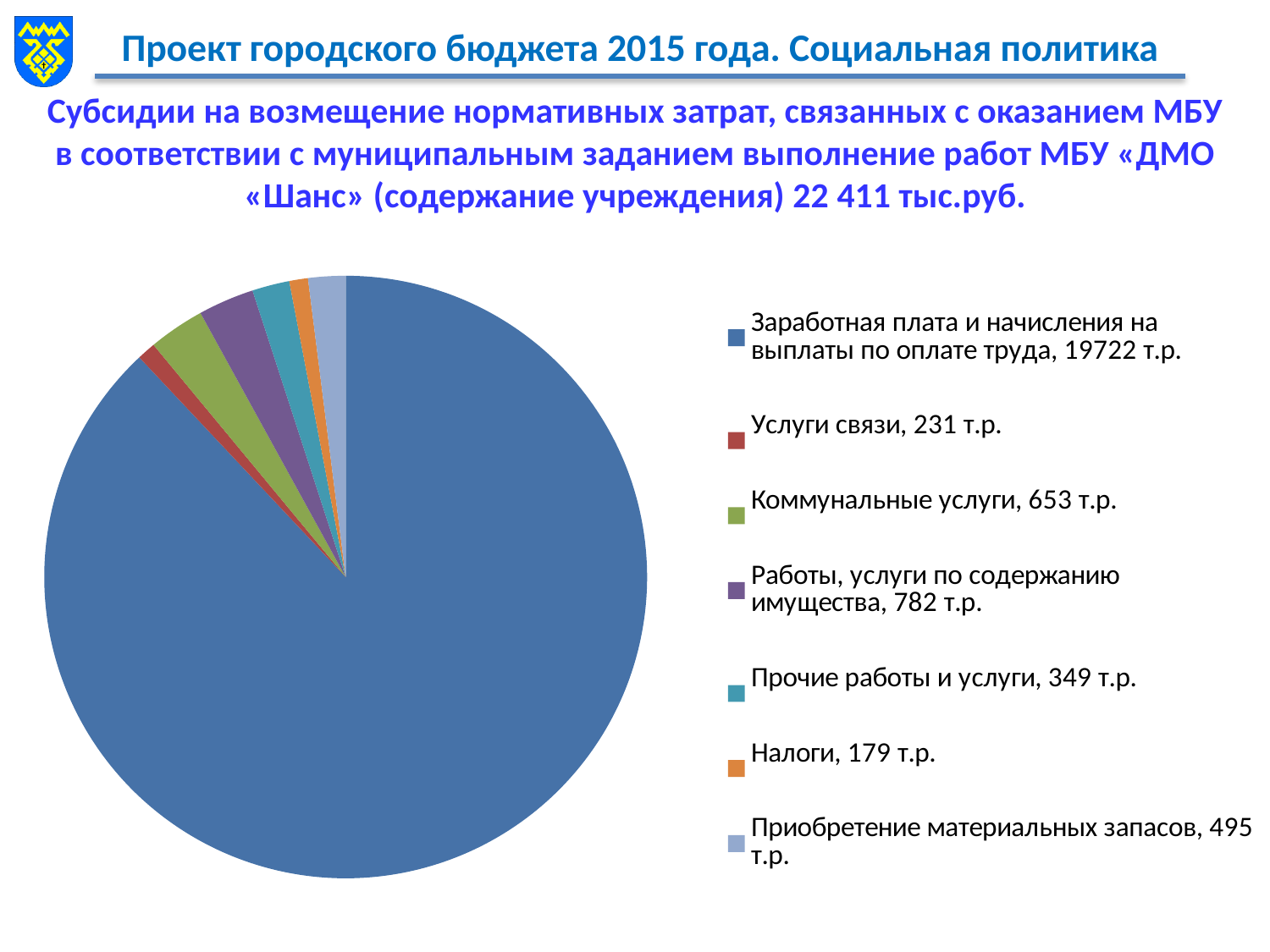
What is the value for Заработная плата и начисления на выплаты по оплате труда? 19722 т.р. What is the value for Приобретение материальных запасов? 495 т.р. Which category has the smallest value? Налоги What is the difference between Работы, услуги по содержанию имущества and Коммунальные услуги? 129 т.р. What is the value for Коммунальные услуги? 653 т.р. Which is larger: Прочие работы и услуги or Услуги связи? Прочие работы и услуги Which category has the largest slice of the pie? Заработная плата и начисления на выплаты по оплате труда What kind of chart is shown on the slide? pie chart What colour is the slice for Коммунальные услуги? green What is the value for Налоги? 179 т.р. How many slices does the pie chart have? 7 What is the total of all the slices in the pie chart? 22411 т.р.